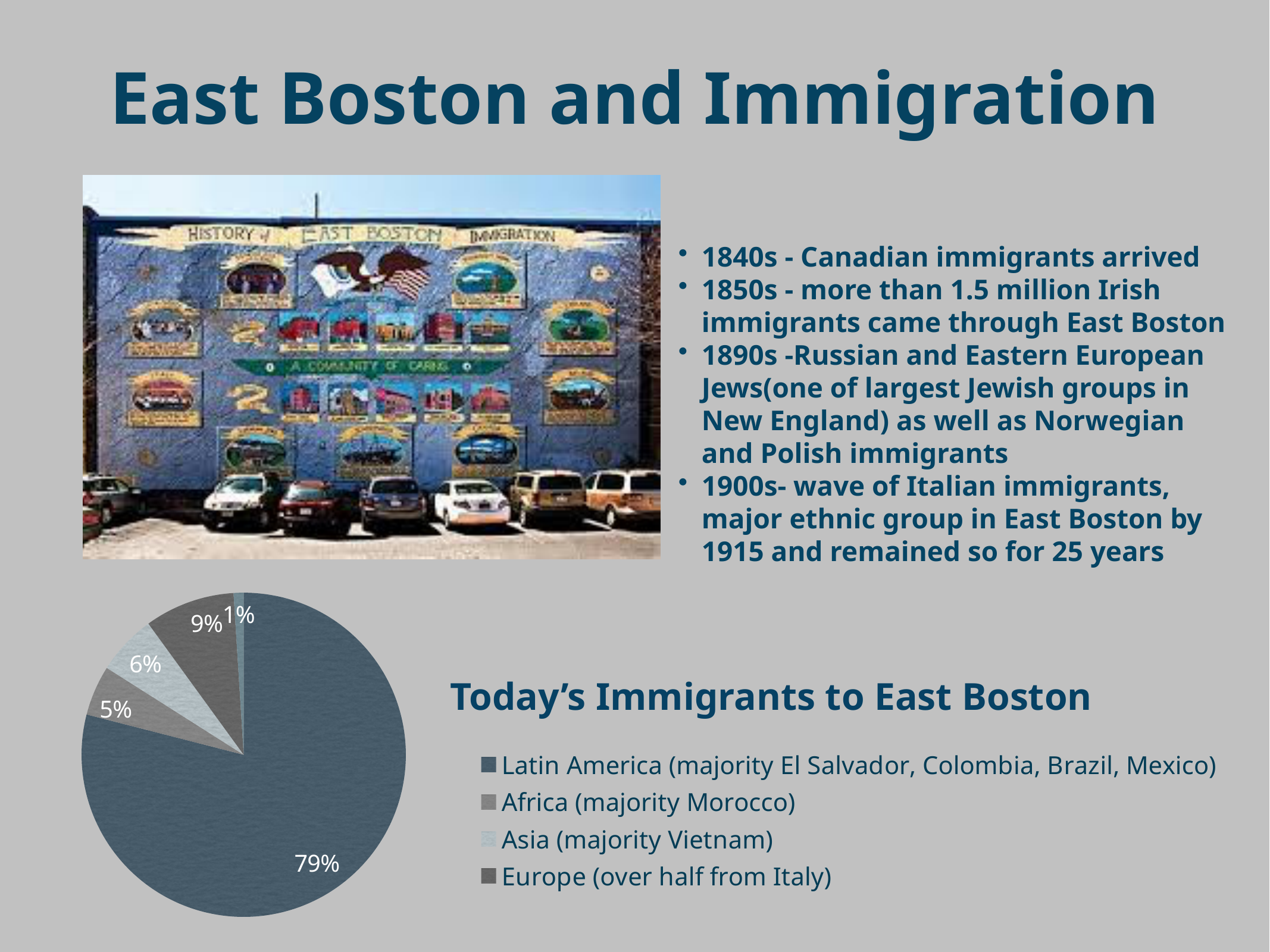
What share of the pie does Asia (majority Vietnam) represent? 6% What is the difference in percentage points between the Latin America slice and the Europe slice? 70% Which category has the largest slice of the pie chart? Latin America Among the categories listed in the legend, which has the smallest share of the pie? Africa What percentage of today's immigrants to East Boston come from Latin America? 79% What percentage of today's immigrants to East Boston come from Africa? 5% What is the title of the pie chart? Today's Immigrants to East Boston How many entries does the pie chart's legend list? 4 How many slices does the pie chart have? 5 Which slice is larger, Asia or Africa? Asia What share of the pie does Europe (over half from Italy) represent? 9% What type of chart is shown on the slide? pie chart